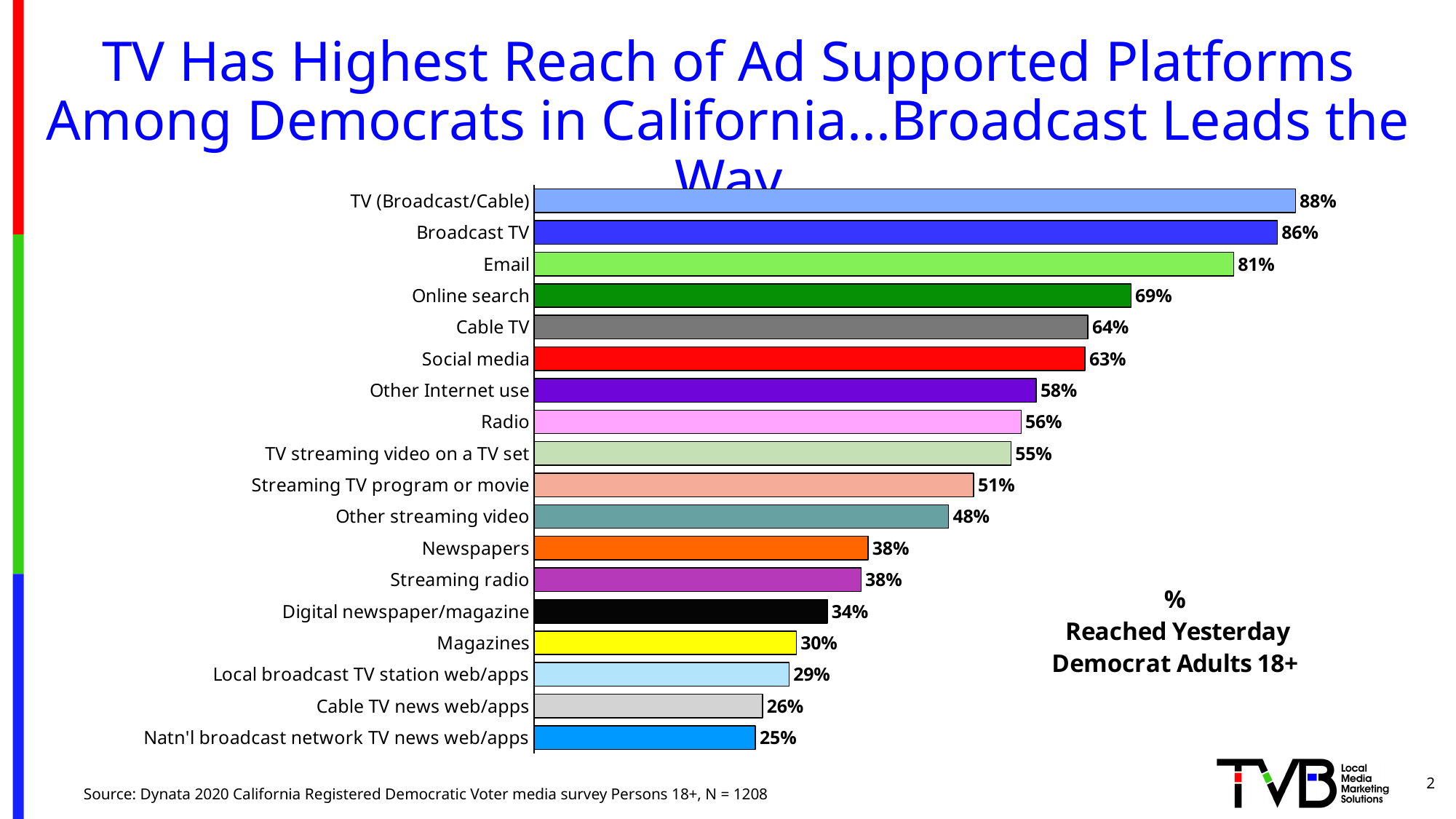
What is the value for Radio? 56% What is the value for Cable TV news web/apps? 26% What is the value for Other streaming video? 48% What is the difference between the values for Magazines and Digital newspaper/magazine? 4% What kind of chart is shown on the slide? Bar chart How many categories are shown in the chart? 18 Which is larger, the value for Online search or the value for Social media? Online search Which category has the highest value? TV (Broadcast/Cable) What is the source cited at the bottom of the slide? Dynata 2020 California Registered Democratic Voter media survey Persons 18+, N = 1208 What is the difference between the values for Broadcast TV and Cable TV? 22% Which category has the lowest value? Natn'l broadcast network TV news web/apps What is the value for Email? 81%